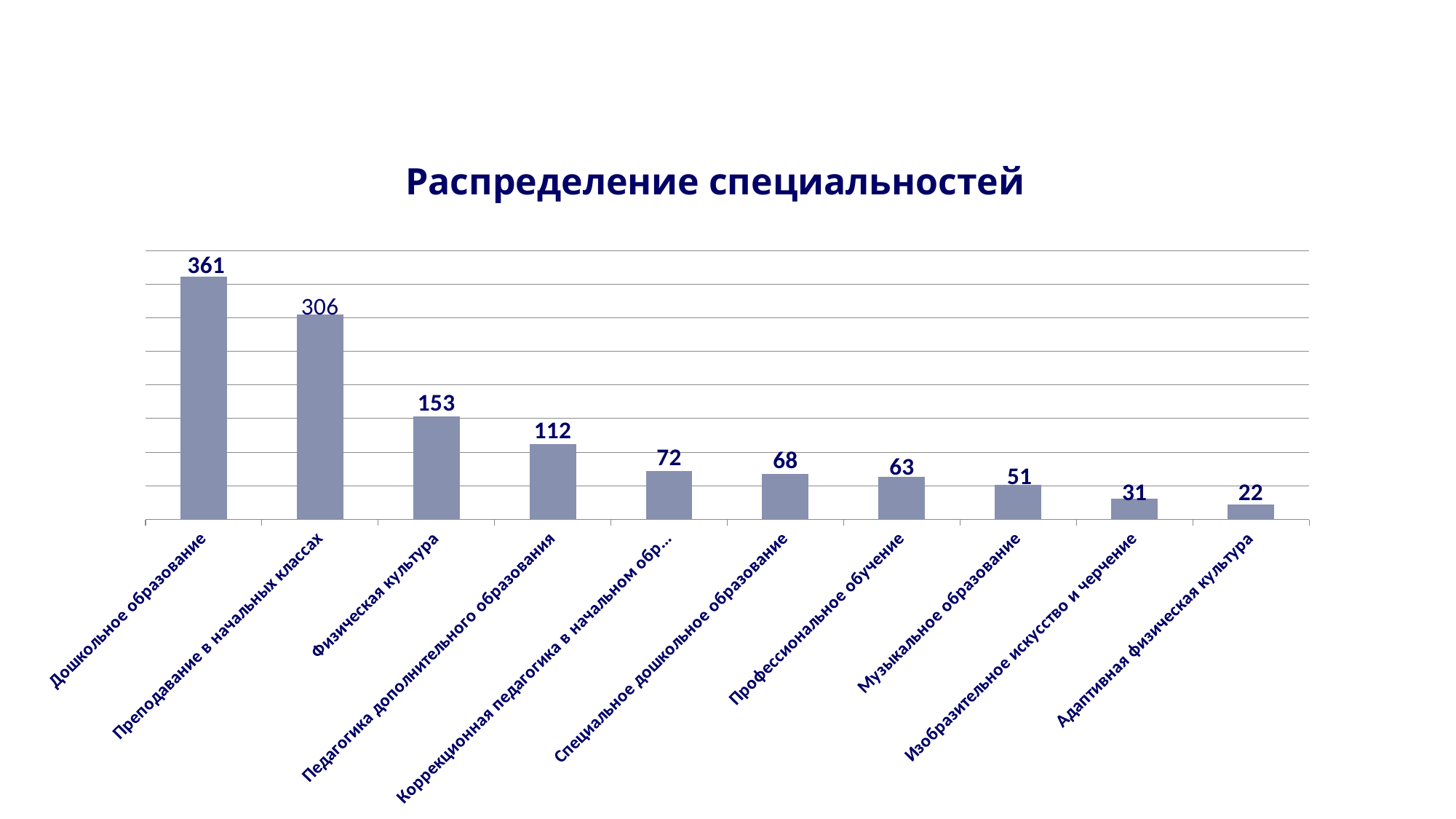
What is the value for Физическая культура? 153 How many categories are shown in the chart? 10 What is the value for Изобразительное искусство и черчение? 31 Which category has the lowest value? Адаптивная физическая культура Which category has the highest value? Дошкольное образование What is the difference between Физическая культура and Педагогика дополнительного образования? 41 What is the difference between Дошкольное образование and Преподавание в начальных классах? 55 What kind of chart is shown? Bar chart What is the value for Музыкальное образование? 51 What is the title of the chart? Распределение специальностей Which is larger: Специальное дошкольное образование or Профессиональное обучение? Специальное дошкольное образование What is the value for Дошкольное образование? 361